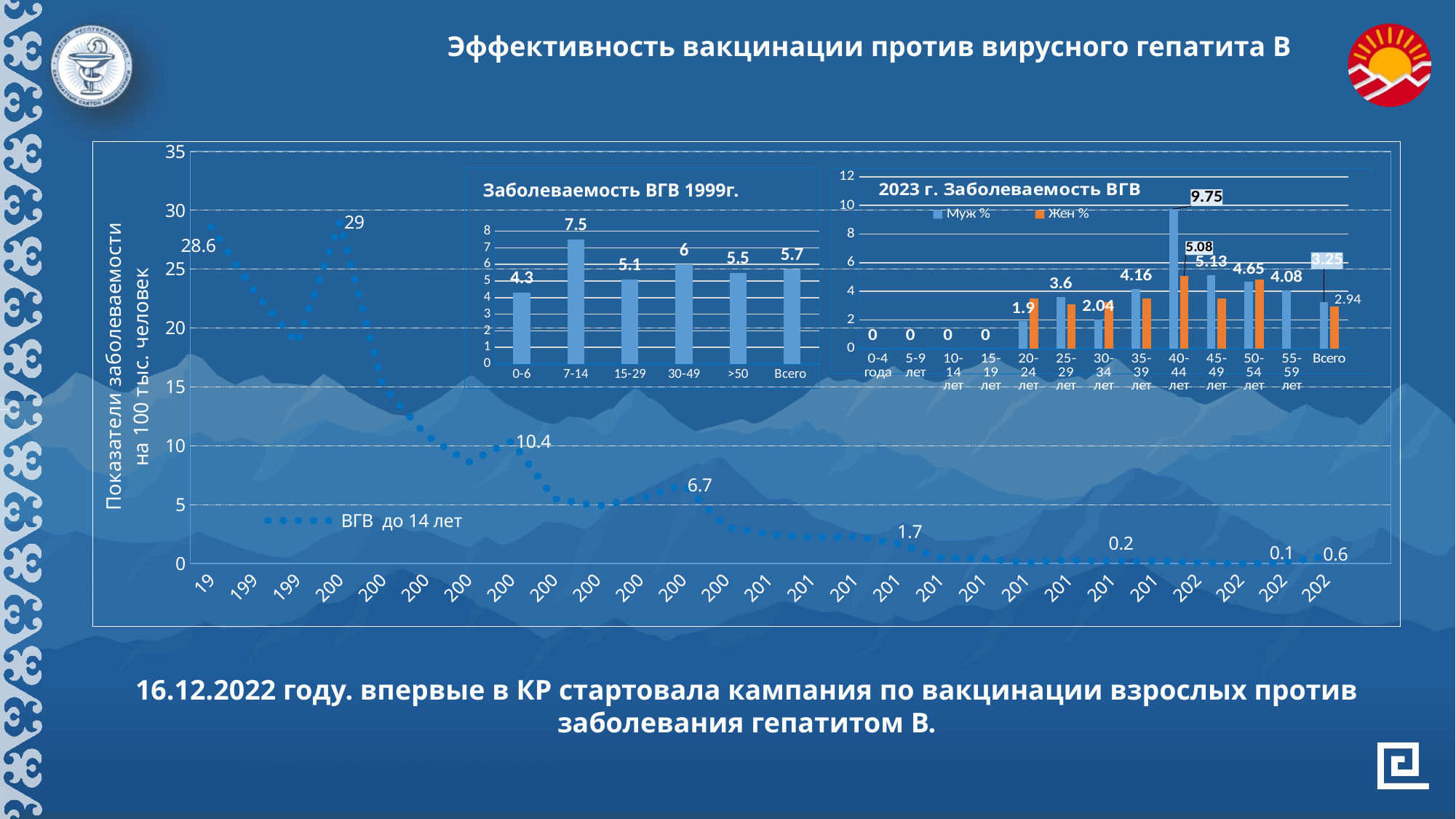
In the chart titled "Заболеваемость ВГВ 1999г.", what is the value for the 7-14 age group? 7.5 How many categories are shown in the chart titled "Заболеваемость ВГВ 1999г."? 6 What kind of chart is the large chart labelled "ВГВ до 14 лет" in the background? line chart How many series does the legend list in the chart titled "2023 г. Заболеваемость ВГВ"? 2 In the chart titled "2023 г. Заболеваемость ВГВ", what is the Муж % value for the 40-44 лет age group? 9.75 In the chart titled "Заболеваемость ВГВ 1999г.", which age group has the highest value? 7-14 In the chart titled "Заболеваемость ВГВ 1999г.", what is the difference between the values for 7-14 and 0-6? 3.2 In the chart titled "Заболеваемость ВГВ 1999г.", which category has the lowest value? 0-6 In the chart titled "2023 г. Заболеваемость ВГВ", which age group has the highest Муж % value? 40-44 лет In the chart titled "2023 г. Заболеваемость ВГВ", which has the larger Муж % value: 25-29 лет or 30-34 лет? 25-29 лет In the large chart labelled "ВГВ до 14 лет", what is the highest labelled value? 29 In the chart titled "2023 г. Заболеваемость ВГВ", what is the Жен % value for the 40-44 лет age group? 5.08